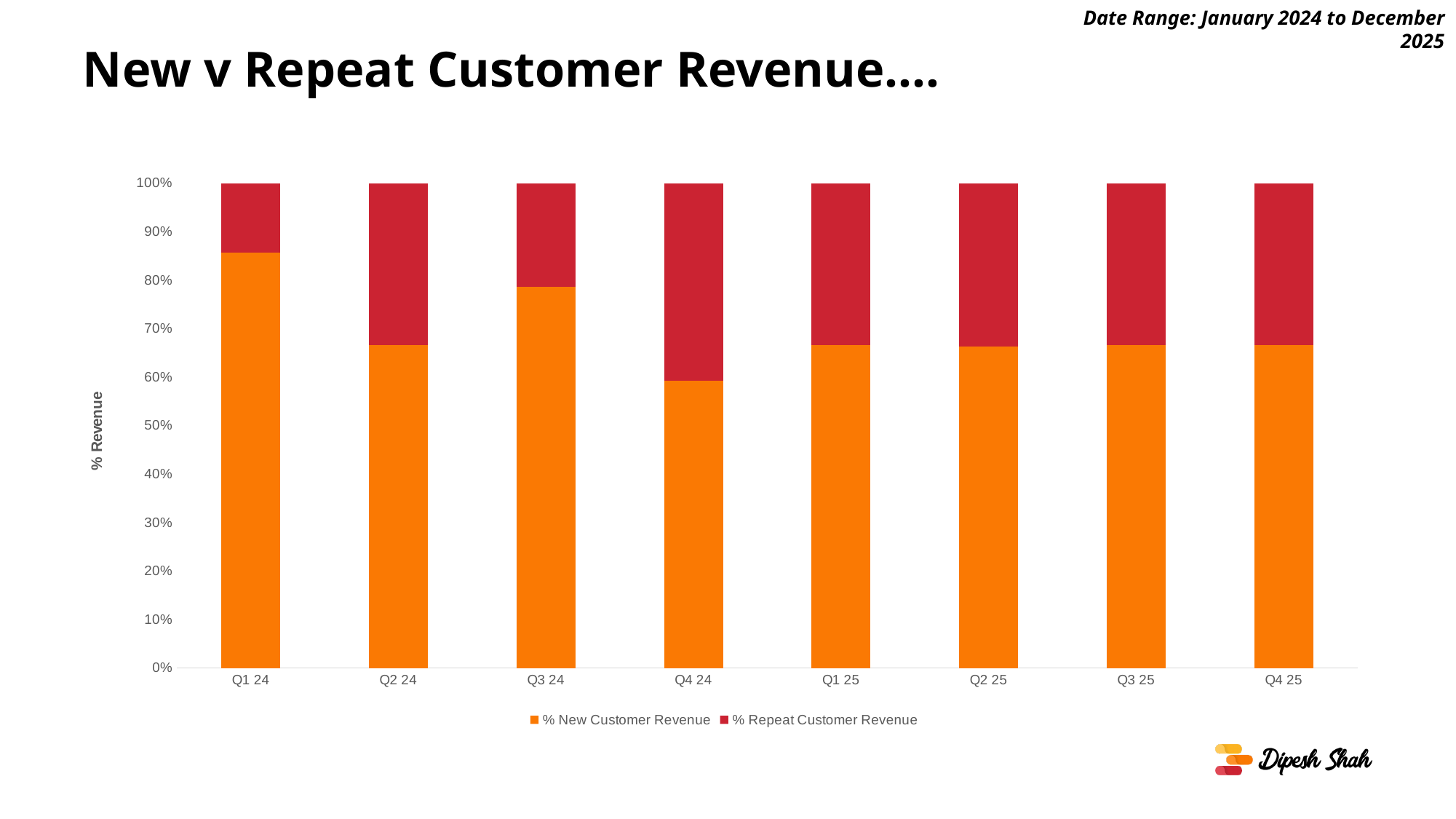
How many quarters are shown on the x axis of the chart? 8 Is the % New Customer Revenue for Q1 24 greater or less than 80%? greater What is the total height of each stacked bar in the chart? 100% Which colour represents % Repeat Customer Revenue in the chart? Red Which quarter has the highest share of % Repeat Customer Revenue? Q4 24 How many series does the chart legend list? 2 Which is larger, the % New Customer Revenue for Q3 24 or for Q4 24? Q3 24 Is the % New Customer Revenue for Q3 24 greater or less than 70%? greater What kind of chart is shown on the slide? Stacked bar chart Which quarter has the highest share of % New Customer Revenue? Q1 24 Which quarter has the lowest share of % New Customer Revenue? Q4 24